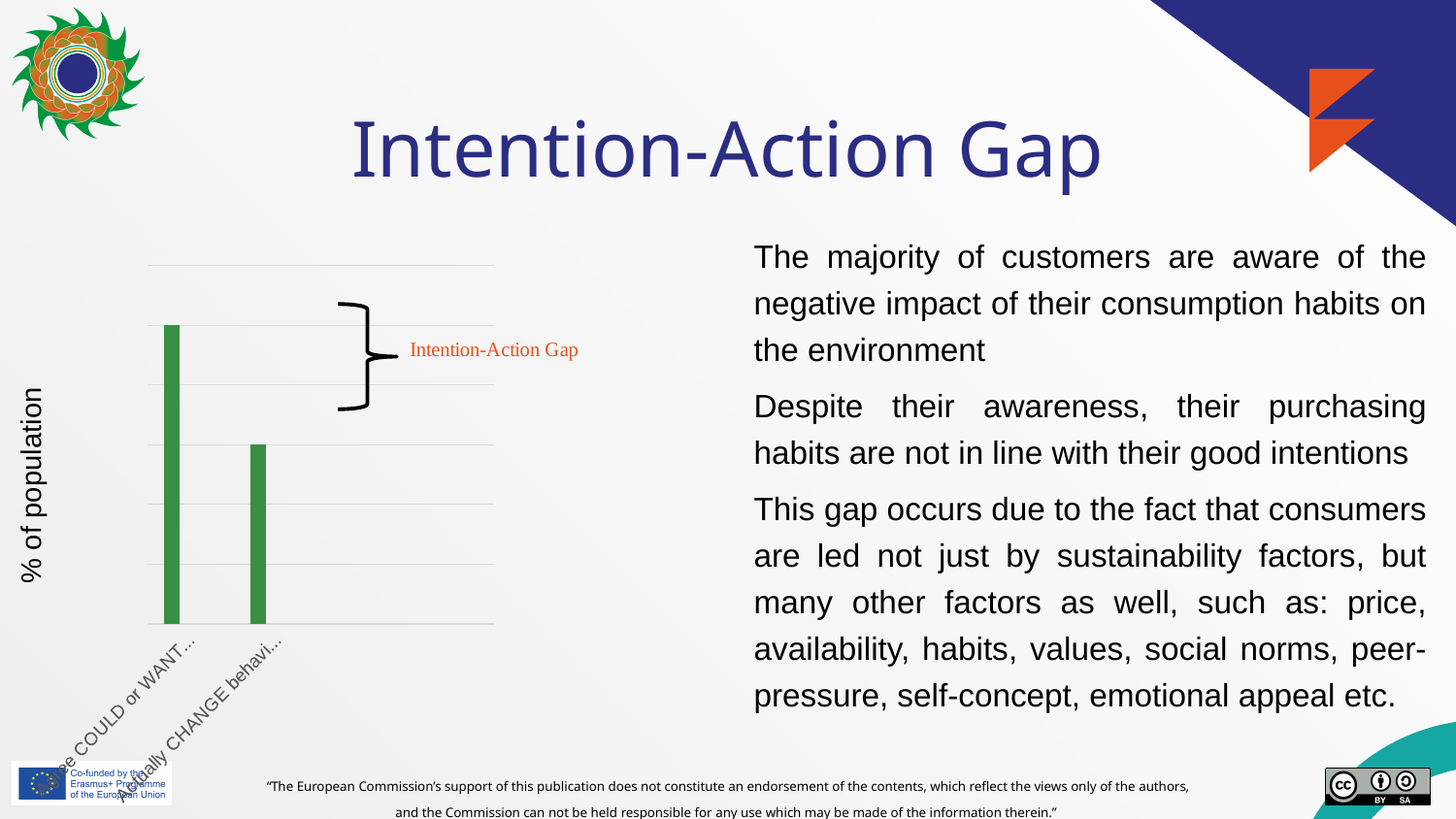
What kind of chart is shown on the left of the slide? bar chart How many bars are plotted in the chart? 2 Which bar in the chart is the highest? the left bar What is the label on the vertical axis of the chart? % of population What text is written next to the bracket annotation on the chart? Intention-Action Gap Do the bar values rise or fall from left to right across the chart? fall Which bar is taller, the left bar or the right bar? the left bar Which bar in the chart is the lowest? the right bar